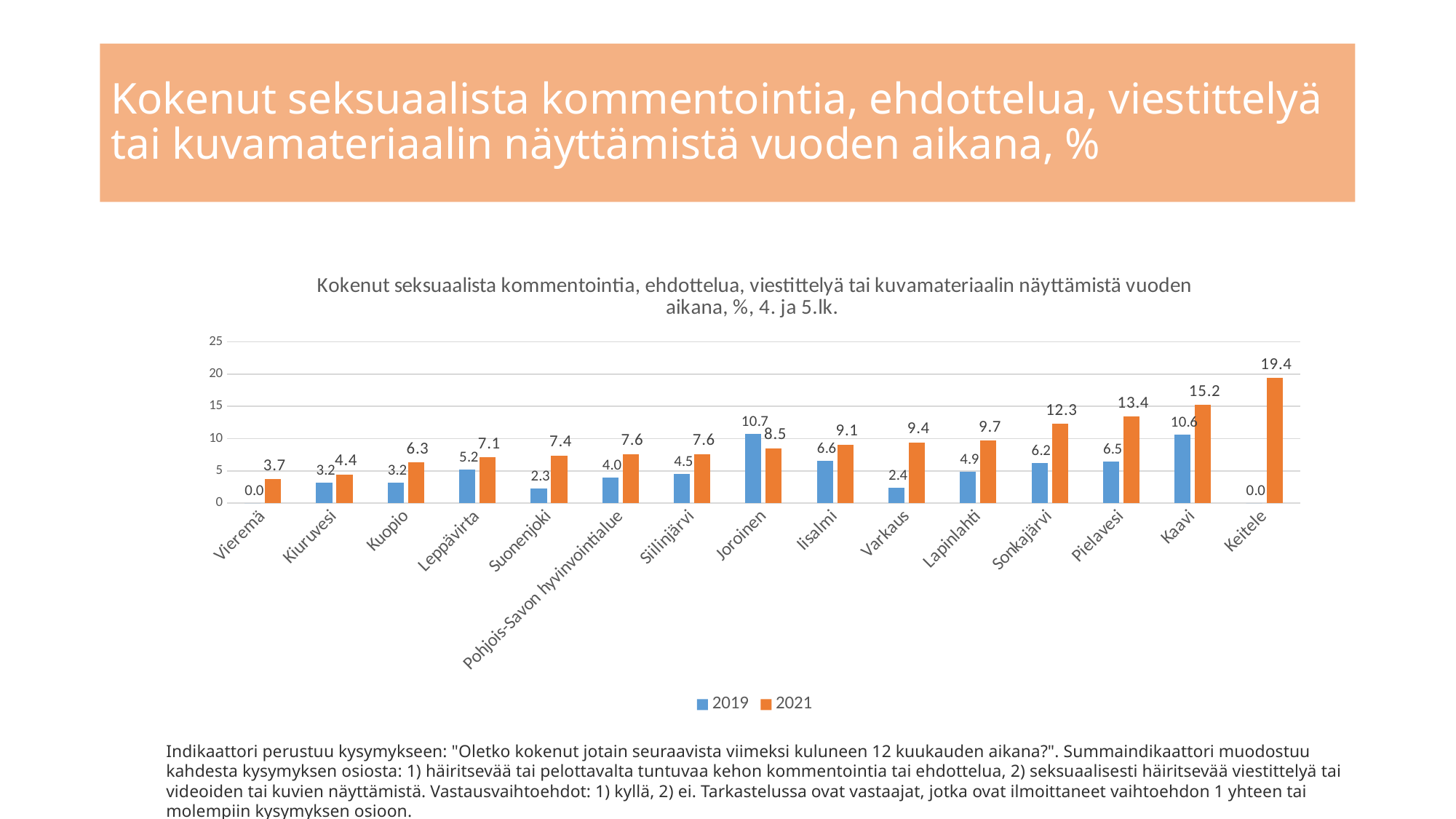
What is the difference between the 2021 and 2019 values for Kaavi? 4.6 Do the 2021 values generally rise or fall from left to right along the x axis? rise What type of chart is shown on the slide? bar chart What is the 2021 value for Keitele? 19.4 Which category has the highest 2021 value? Keitele What is the 2019 value for Varkaus? 2.4 How many municipalities/areas are shown on the x axis? 15 Which category has the lowest 2021 value? Vieremä What is the 2021 value for Pohjois-Savon hyvinvointialue? 7.6 How many series does the legend list? 2 Which two years are listed in the legend? 2019 and 2021 For Joroinen, which is larger: the 2019 value or the 2021 value? 2019